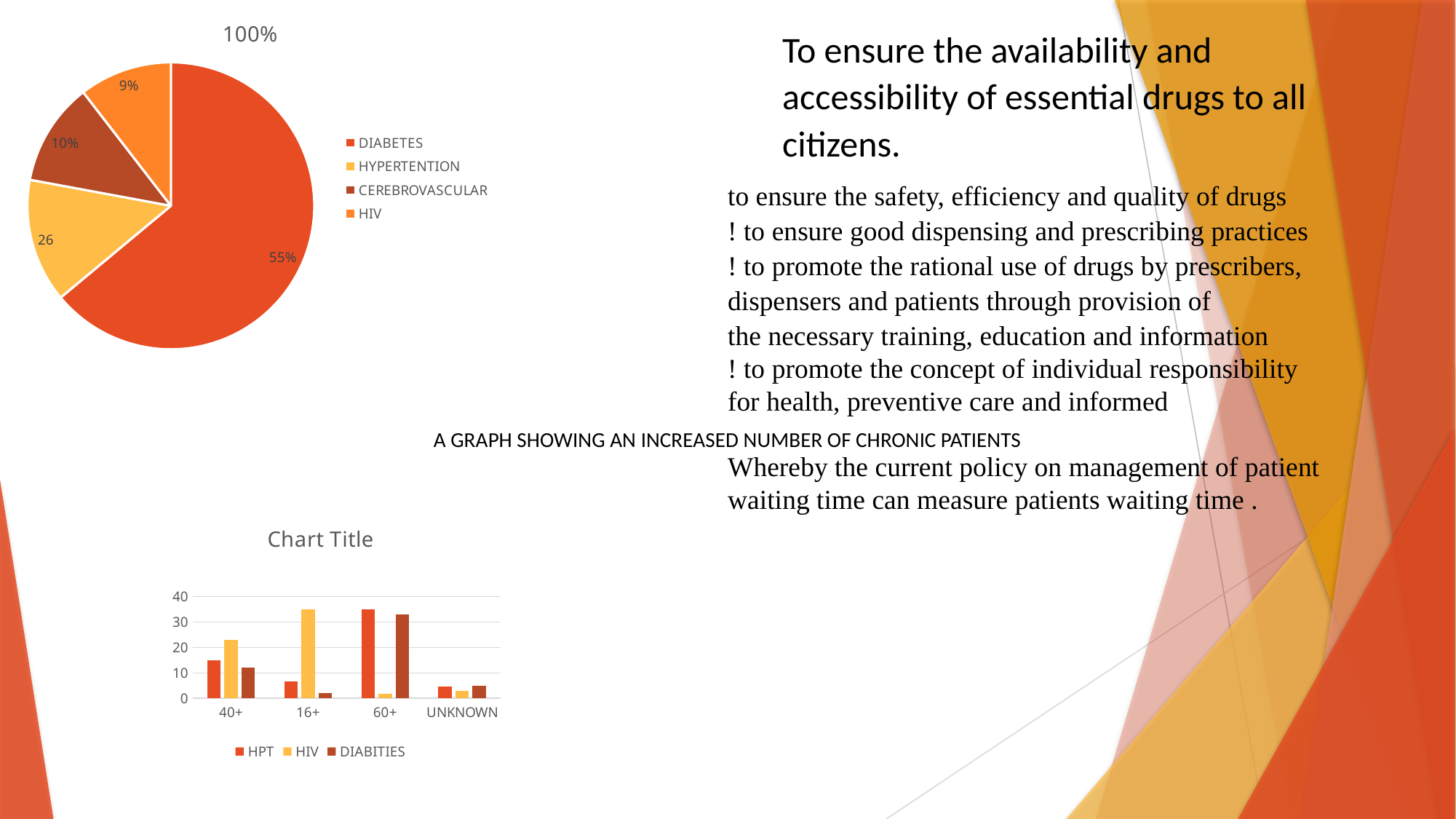
How many series does the legend of the chart titled "Chart Title" list? 3 In the chart titled "Chart Title", which series has the highest bar for 40+? HIV In the chart titled "Chart Title", is the DIABITIES value for 16+ greater or less than 10? less How many categories does the legend of the pie chart at the top left list? 4 In the pie chart at the top left, what value is labelled for the HYPERTENTION slice? 26 In the pie chart at the top left, what share is labelled for DIABETES? 55% In the chart titled "Chart Title", is the HIV value for 16+ greater or less than 30? greater In the chart titled "Chart Title", which is larger for 60+: HPT or HIV? HPT In the pie chart at the top left, which category has the smallest slice? HIV What kind of chart is the chart titled "Chart Title" at the bottom left? bar chart In the pie chart at the top left, which category has the largest slice? DIABETES In the pie chart at the top left, what share is labelled for HIV? 9%